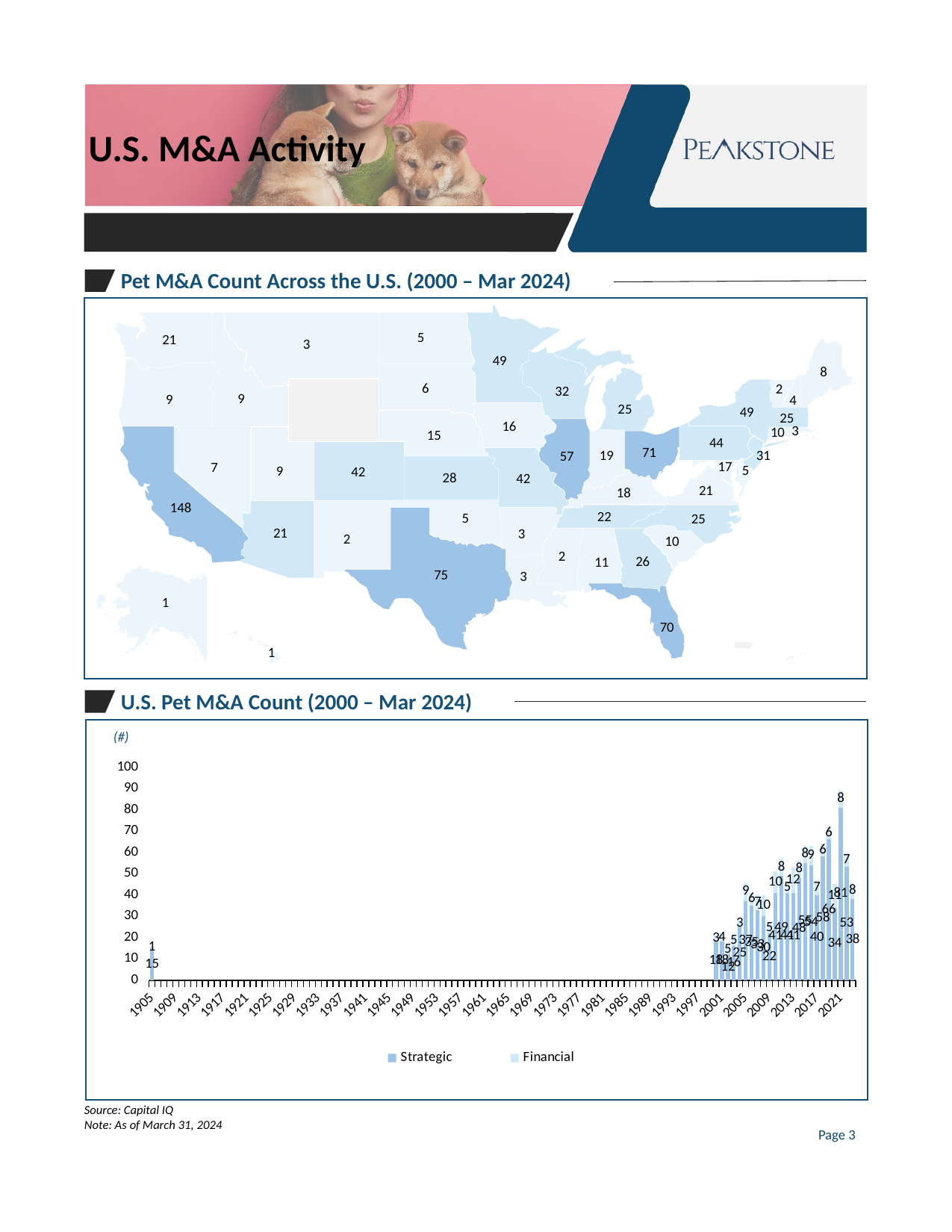
On the map chart 'Pet M&A Count Across the U.S. (2000 – Mar 2024)', which state has the highest count? California On the map chart 'Pet M&A Count Across the U.S. (2000 – Mar 2024)', which has the larger count, Texas or Florida? Texas On the map chart 'Pet M&A Count Across the U.S. (2000 – Mar 2024)', what is the count shown for Ohio? 71 On the map chart 'Pet M&A Count Across the U.S. (2000 – Mar 2024)', what is the count shown for Florida? 70 On the map chart 'Pet M&A Count Across the U.S. (2000 – Mar 2024)', what is the count shown for Illinois? 57 On the map chart 'Pet M&A Count Across the U.S. (2000 – Mar 2024)', what is the count shown for Texas? 75 What kind of chart is 'U.S. Pet M&A Count (2000 – Mar 2024)'? Bar chart How many series does the legend of the chart 'U.S. Pet M&A Count (2000 – Mar 2024)' list? 2 What are the two series named in the legend of the chart 'U.S. Pet M&A Count (2000 – Mar 2024)'? Strategic and Financial On the map chart 'Pet M&A Count Across the U.S. (2000 – Mar 2024)', what is the difference between the counts for California and Texas? 73 On the map chart 'Pet M&A Count Across the U.S. (2000 – Mar 2024)', what is the count shown for California? 148 On the map chart 'Pet M&A Count Across the U.S. (2000 – Mar 2024)', what is the count shown for Minnesota? 49